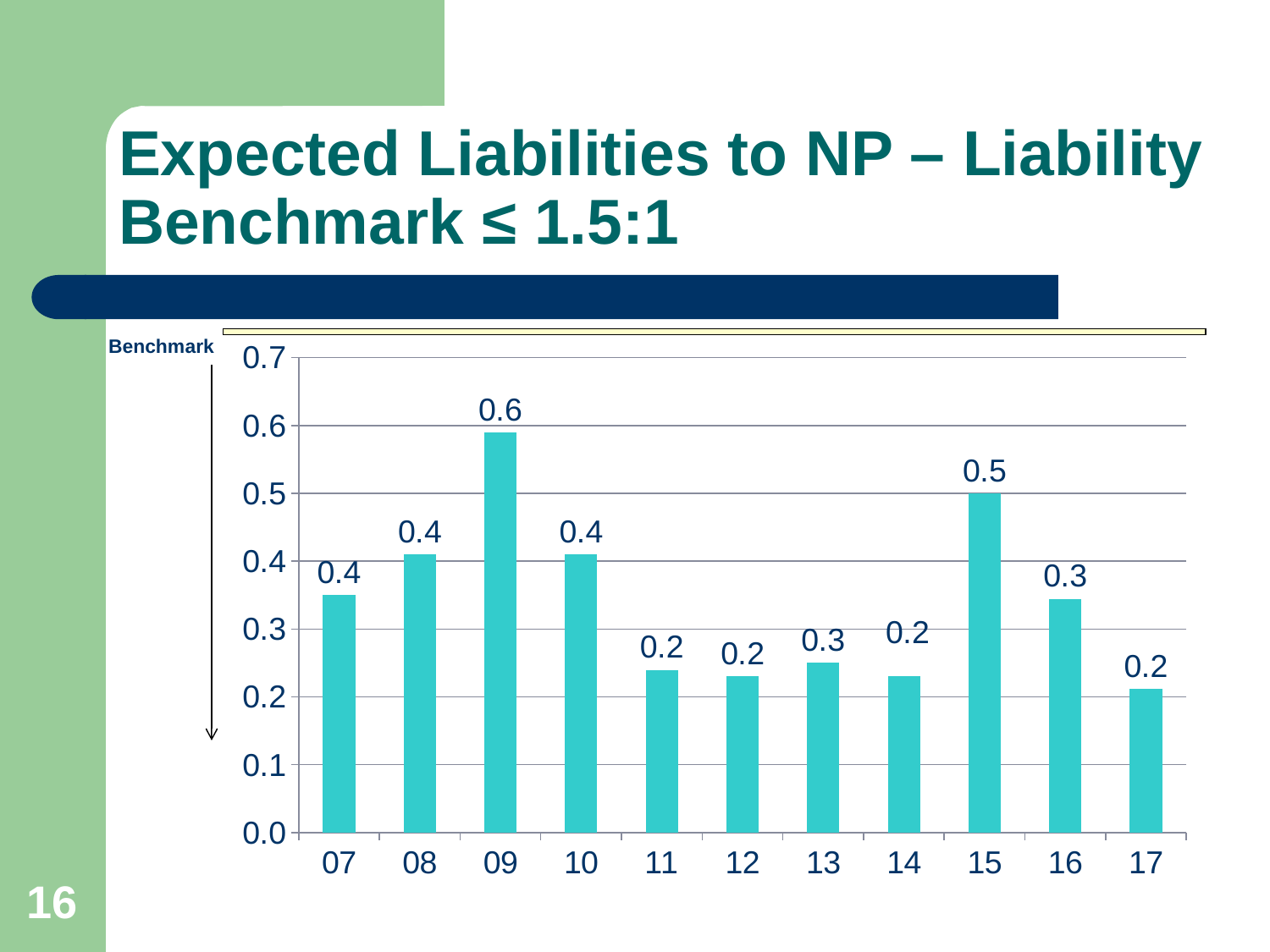
Is the value for 09 greater or less than 0.5? greater What is the value shown for 15? 0.5 What is the value shown for 17? 0.2 Which year has the highest value? 09 Is the value for 11 greater or less than 0.3? less What is the value shown for 09? 0.6 How many years are shown on the x axis? 11 Which is larger, the value for 09 or the value for 15? 09 What kind of chart is shown on the slide? bar chart What is the difference between the values for 09 and 15? 0.1 Do the values rise or fall from 09 to 11? fall What is the value shown for 13? 0.3